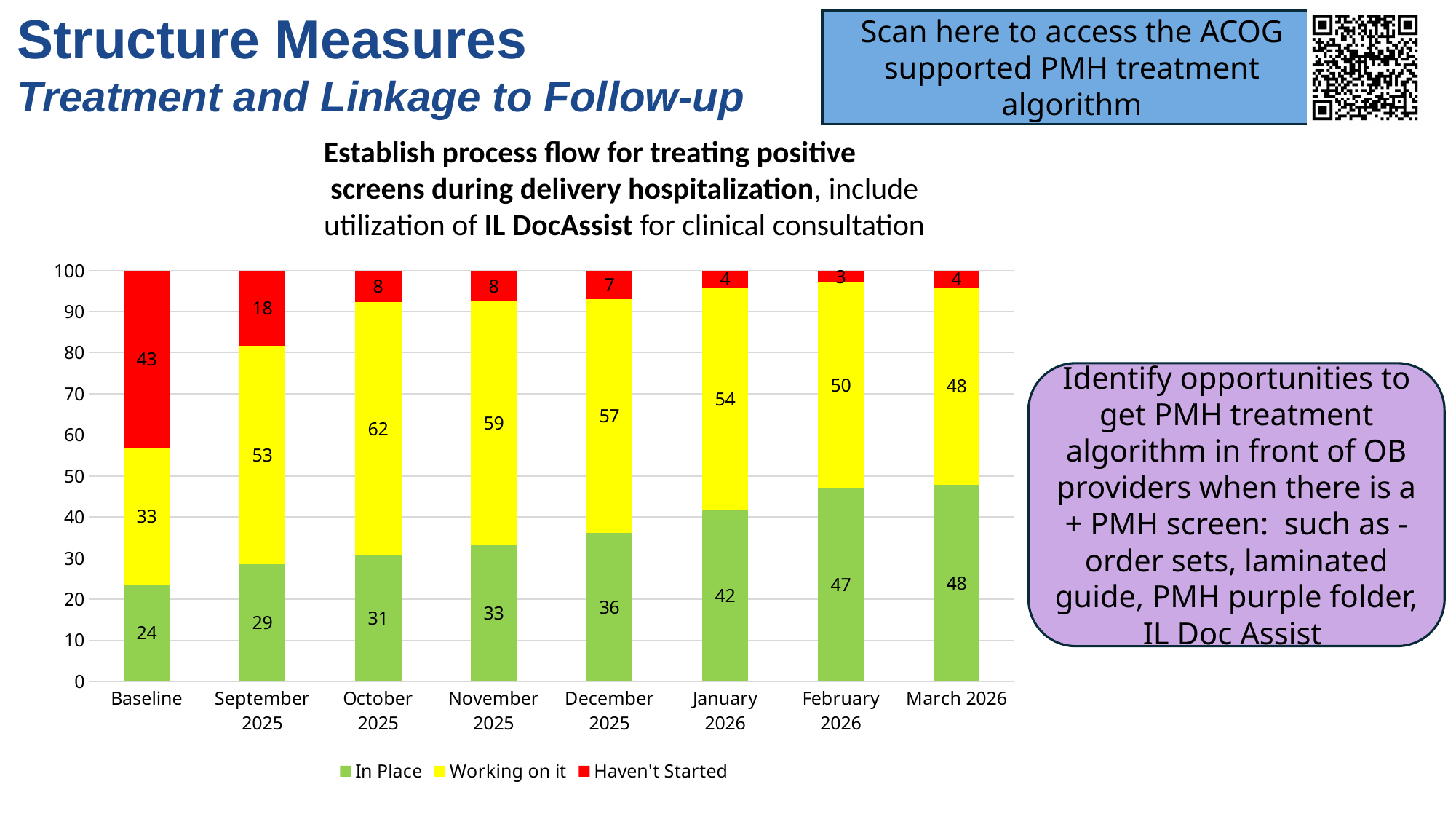
Does the In Place value rise or fall from Baseline to March 2026? Rise How many series does the legend list? 3 What is the value for Haven't Started in September 2025? 18 Which is larger, the In Place value in December 2025 or in January 2026? January 2026 What is the value for In Place at Baseline? 24 Which category has the highest In Place value? March 2026 Which category has the lowest Haven't Started value? February 2026 What is the total of the stacked bar for November 2025? 100 What kind of chart is shown? Stacked bar chart How many categories are shown on the x axis? 8 What is the difference between the Haven't Started values at Baseline and in March 2026? 39 What is the value for Working on it in October 2025? 62